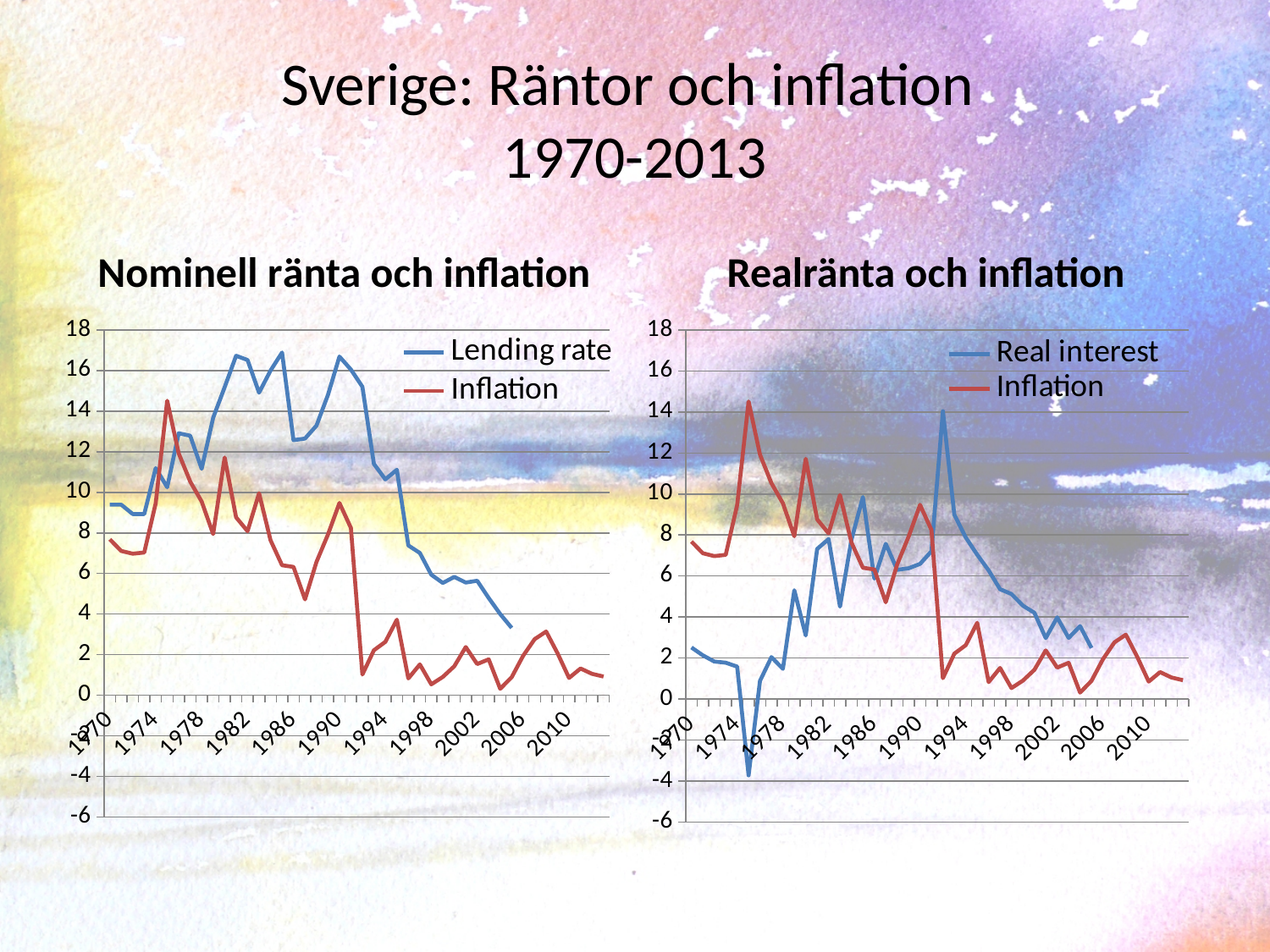
In the right chart "Realränta och inflation", what colour is the Real interest line? Blue In the left chart "Nominell ränta och inflation", which two series are listed in the legend? Lending rate and Inflation In the right chart "Realränta och inflation", is the Real interest value for 1993 greater or less than 10? less In the left chart "Nominell ränta och inflation", is the Lending rate value for 1970 greater or less than 8? greater In the right chart "Realränta och inflation", is the Real interest value for 1977 greater or less than 0? greater How many series does the legend of the right chart "Realränta och inflation" list? 2 In the left chart "Nominell ränta och inflation", does the Lending rate rise or fall between 1994 and 2006? Fall What kind of chart is the left chart titled "Nominell ränta och inflation"? Line chart In the left chart "Nominell ränta och inflation", which series has the higher value in 1985, Lending rate or Inflation? Lending rate In the right chart "Realränta och inflation", which series has the higher value in 1977, Real interest or Inflation? Inflation